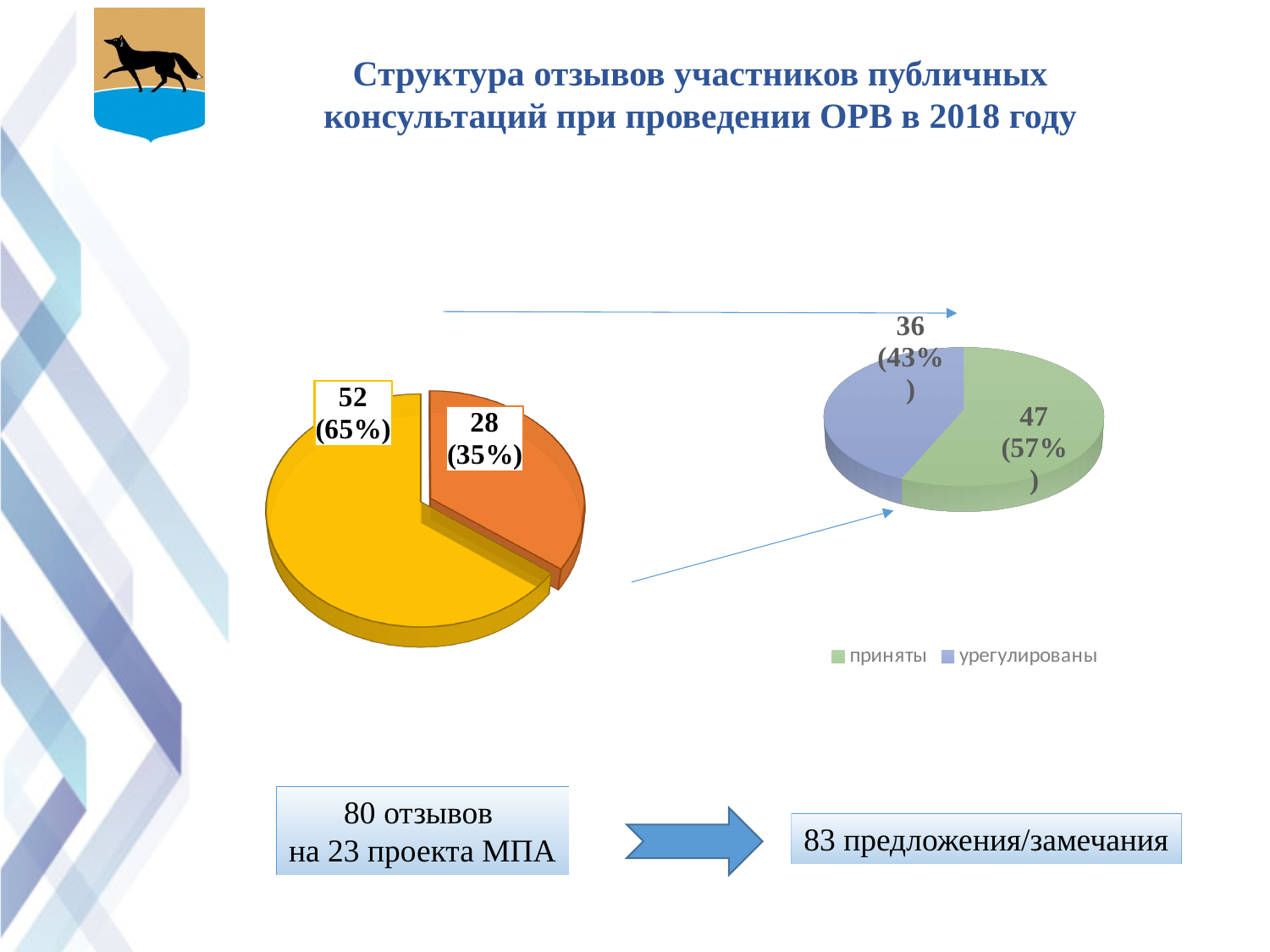
In the left pie chart, what value is shown for the yellow slice? 52 (65%) In the right pie chart, what value is shown for урегулированы? 36 (43%) How many slices does the left pie chart have? 2 What kind of chart is the chart on the right of the slide? pie chart In the right pie chart, which category has the larger value, приняты or урегулированы? приняты In the left pie chart, what is the difference between the yellow slice value and the orange slice value? 24 In the left pie chart, what share of the pie does the orange slice represent? 35% In the left pie chart, what value is shown for the orange slice? 28 (35%) In the right pie chart, what value is shown for приняты? 47 (57%) What kind of chart is the chart on the left of the slide? pie chart How many entries does the legend of the right pie chart list? 2 In the right pie chart, what is the difference between приняты and урегулированы? 11